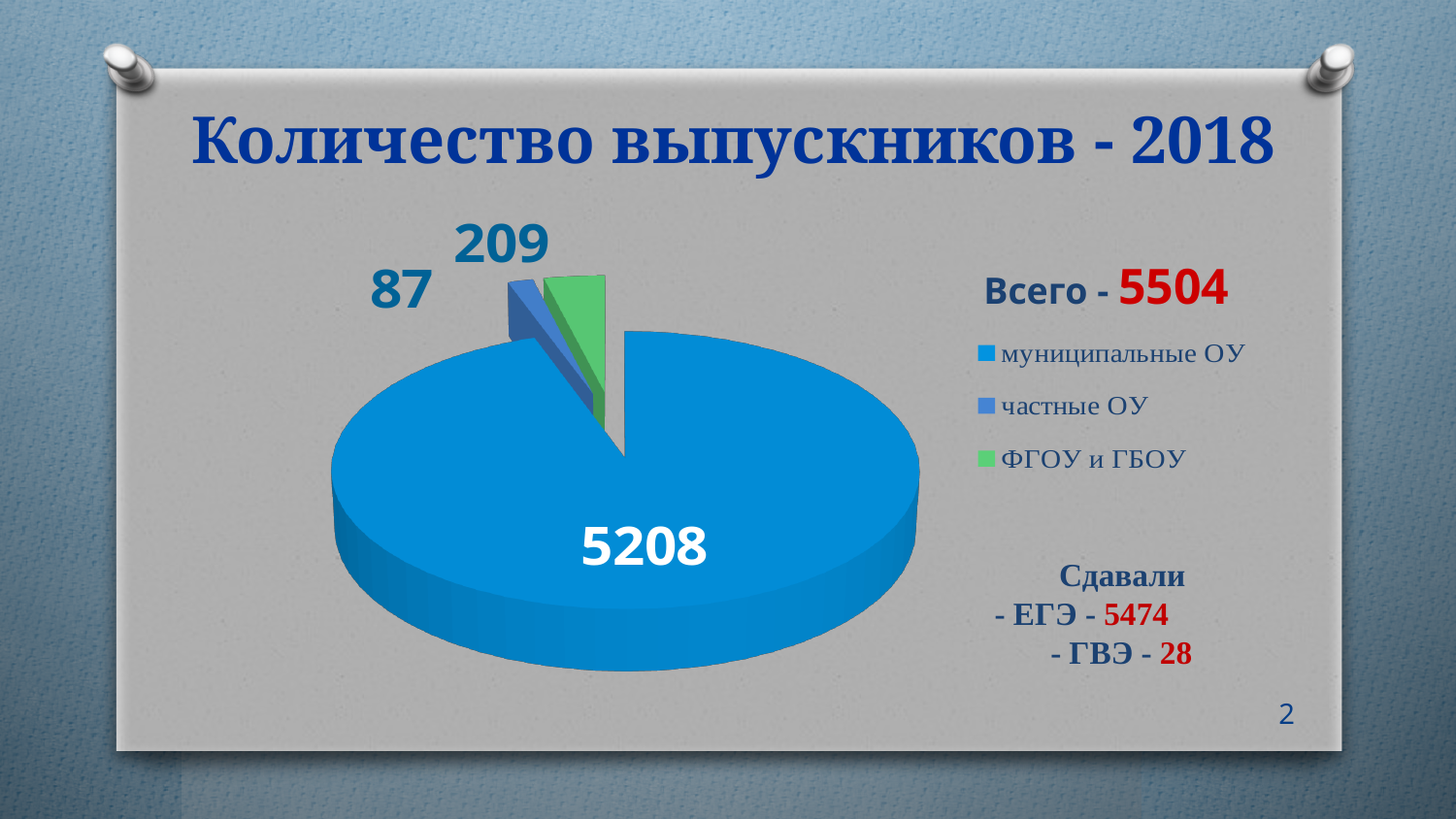
What is the value for муниципальные ОУ? 5208 What is the value for ФГОУ и ГБОУ? 209 What is the difference between the values for ФГОУ и ГБОУ and частные ОУ? 122 How many entries does the legend list? 3 Which is larger, the value for ФГОУ и ГБОУ or the value for частные ОУ? ФГОУ и ГБОУ Which category has the largest slice of the pie? муниципальные ОУ What kind of chart is shown on the slide? pie chart How many slices does the pie chart have? 3 Which category has the smallest slice of the pie? частные ОУ What is the total of all slices in the pie chart (Всего)? 5504 What is the value for частные ОУ? 87 What is the title of the chart on the slide? Количество выпускников - 2018